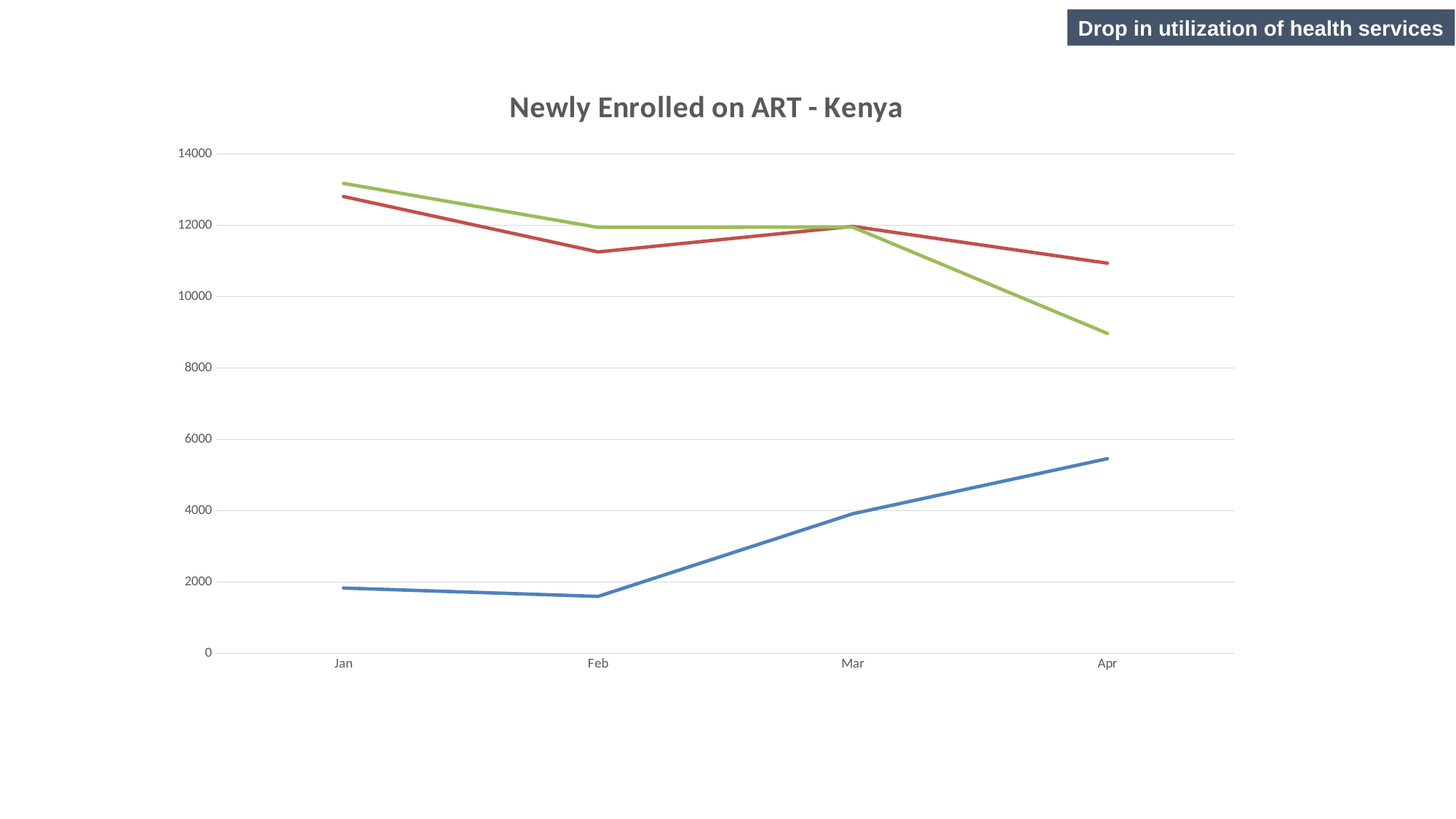
Is the value of the red line in Jan greater or less than 12000? greater Is the value of the blue line in Apr greater or less than 4000? greater How many months are shown on the x axis of the chart? 4 Is the value of the blue line in Feb greater or less than 2000? less Does the green line rise or fall from Jan to Apr overall? fall In which month does the blue line reach its lowest value? Feb How many lines are plotted on the chart? 3 What kind of chart is shown on the slide? line chart Does the blue line rise or fall from Feb to Apr? rise In Apr, which line has the higher value, the red line or the green line? red line What is the title of the chart? Newly Enrolled on ART - Kenya